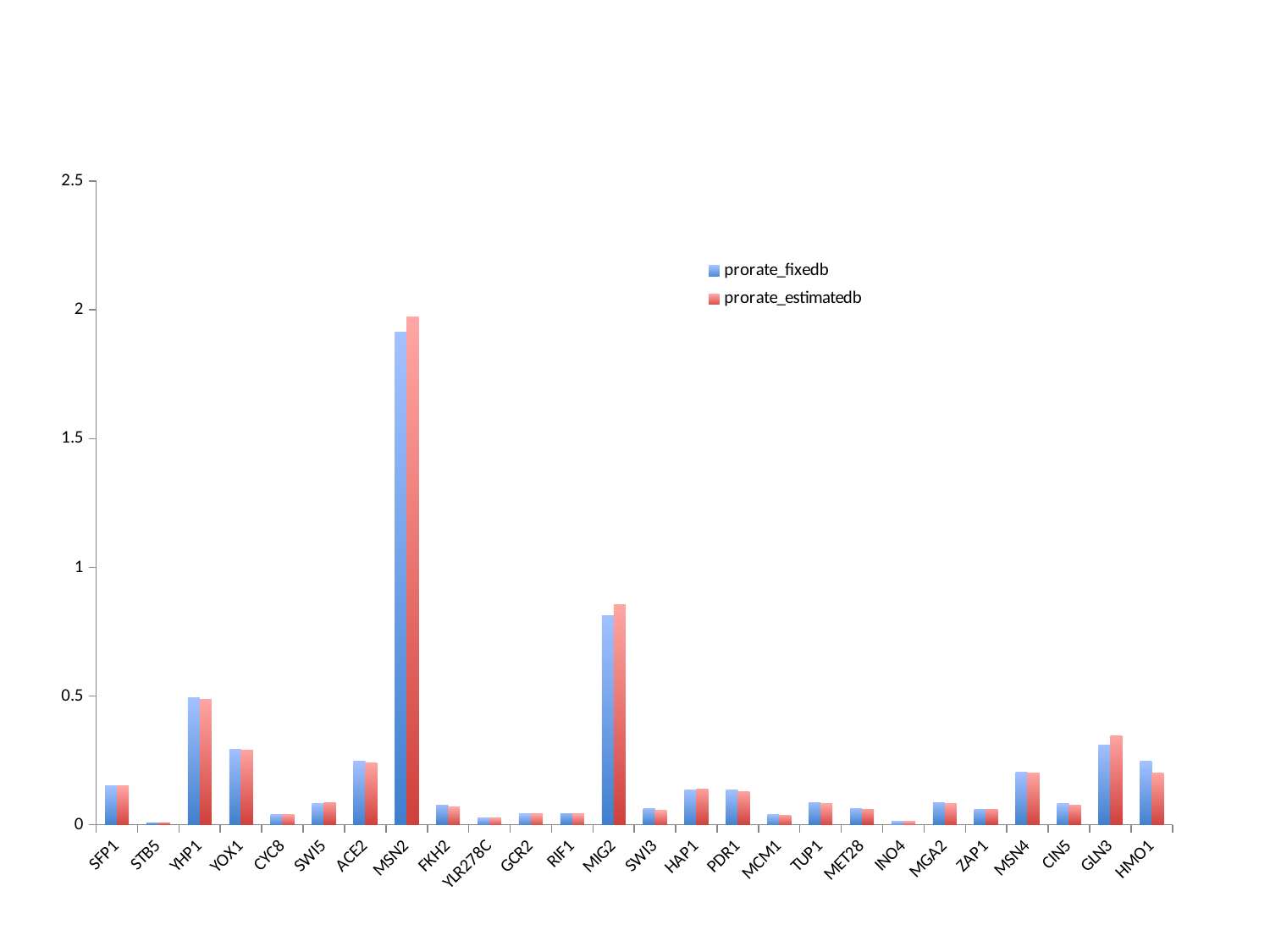
Which is larger, the prorate_fixedb value for MSN2 or the prorate_fixedb value for MIG2? MSN2 For GLN3, which series has the larger value, prorate_fixedb or prorate_estimatedb? prorate_estimatedb What colour represents the prorate_estimatedb series? red How many categories are shown along the x axis? 26 Which category has the highest value for prorate_estimatedb? MSN2 Is the prorate_fixedb value for YHP1 greater or less than 1? less Which category has the highest value for prorate_fixedb? MSN2 What kind of chart is shown on the slide? bar chart For HMO1, which series has the larger value, prorate_fixedb or prorate_estimatedb? prorate_fixedb Is the prorate_fixedb value for MIG2 greater or less than 1? less How many series does the legend list? 2 Is the prorate_estimatedb value for MSN2 greater or less than 1.5? greater